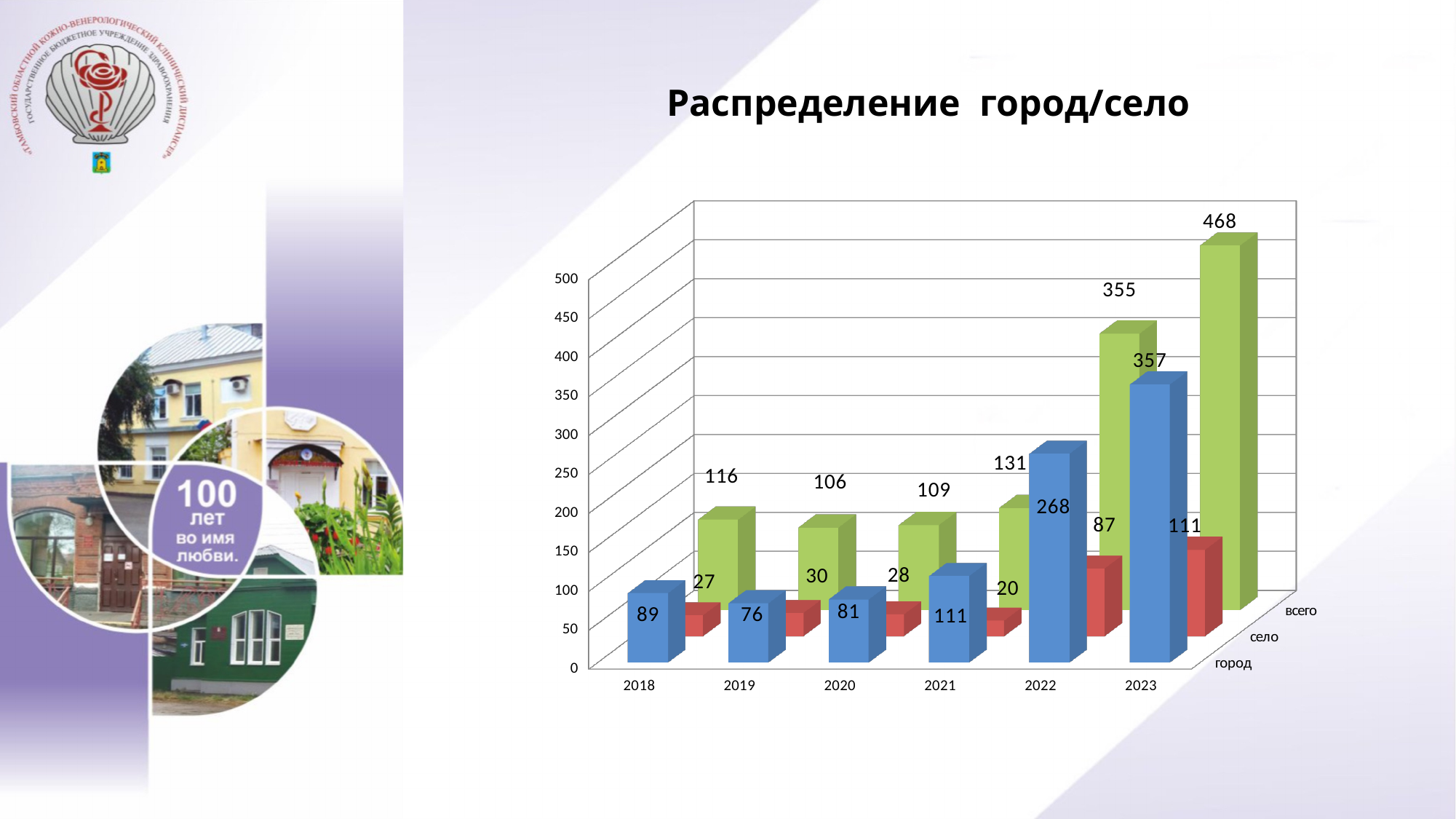
In which year is the value for всего highest? 2023 Which is larger, the город value in 2021 or the село value in 2023? They are equal (111) What is the difference between the всего values for 2023 and 2022? 113 What is the title of the chart? Распределение город/село What is the value for всего in 2018? 116 What is the value for город in 2023? 357 How many years are shown on the x axis? 6 In which year is the value for город lowest? 2019 What kind of chart is shown on the slide? Bar chart What is the value for село in 2021? 20 What is the value for село in 2022? 87 How many series does the chart show? 3